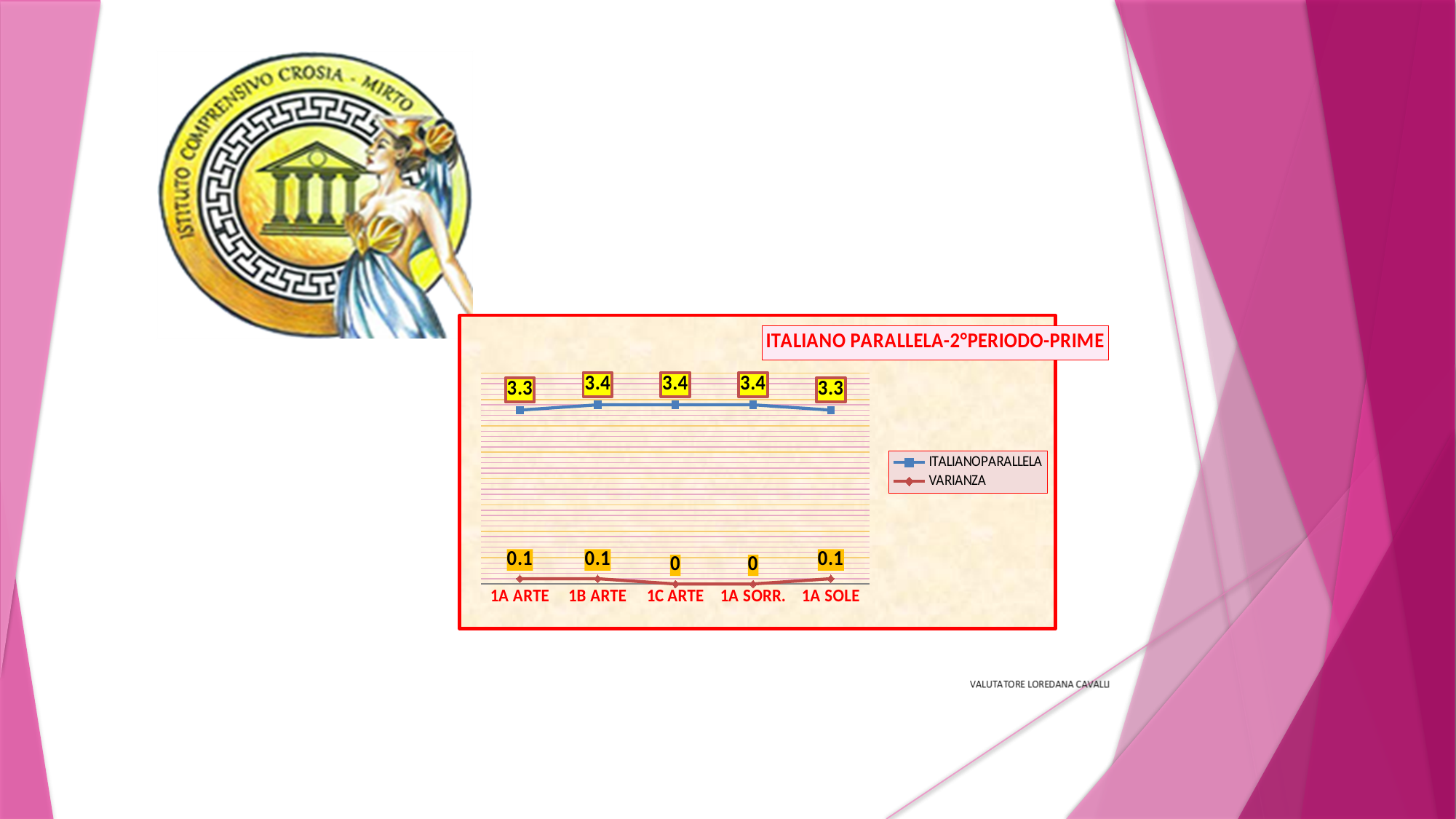
Which has the larger ITALIANOPARALLELA value, 1A ARTE or 1B ARTE? 1B ARTE What is the ITALIANOPARALLELA value for 1C ARTE? 3.4 What is the ITALIANOPARALLELA value for 1A ARTE? 3.3 How many series does the legend list? 2 What is the difference between the ITALIANOPARALLELA values for 1B ARTE and 1A SOLE? 0.1 What is the title of the chart? ITALIANO PARALLELA-2°PERIODO-PRIME What is the VARIANZA value for 1A SORR.? 0 What type of chart is shown on the slide? line chart Which series is drawn in blue in the legend? ITALIANOPARALLELA How many categories are shown on the x axis? 5 Which has the larger VARIANZA value, 1A ARTE or 1C ARTE? 1A ARTE What is the VARIANZA value for 1A SOLE? 0.1